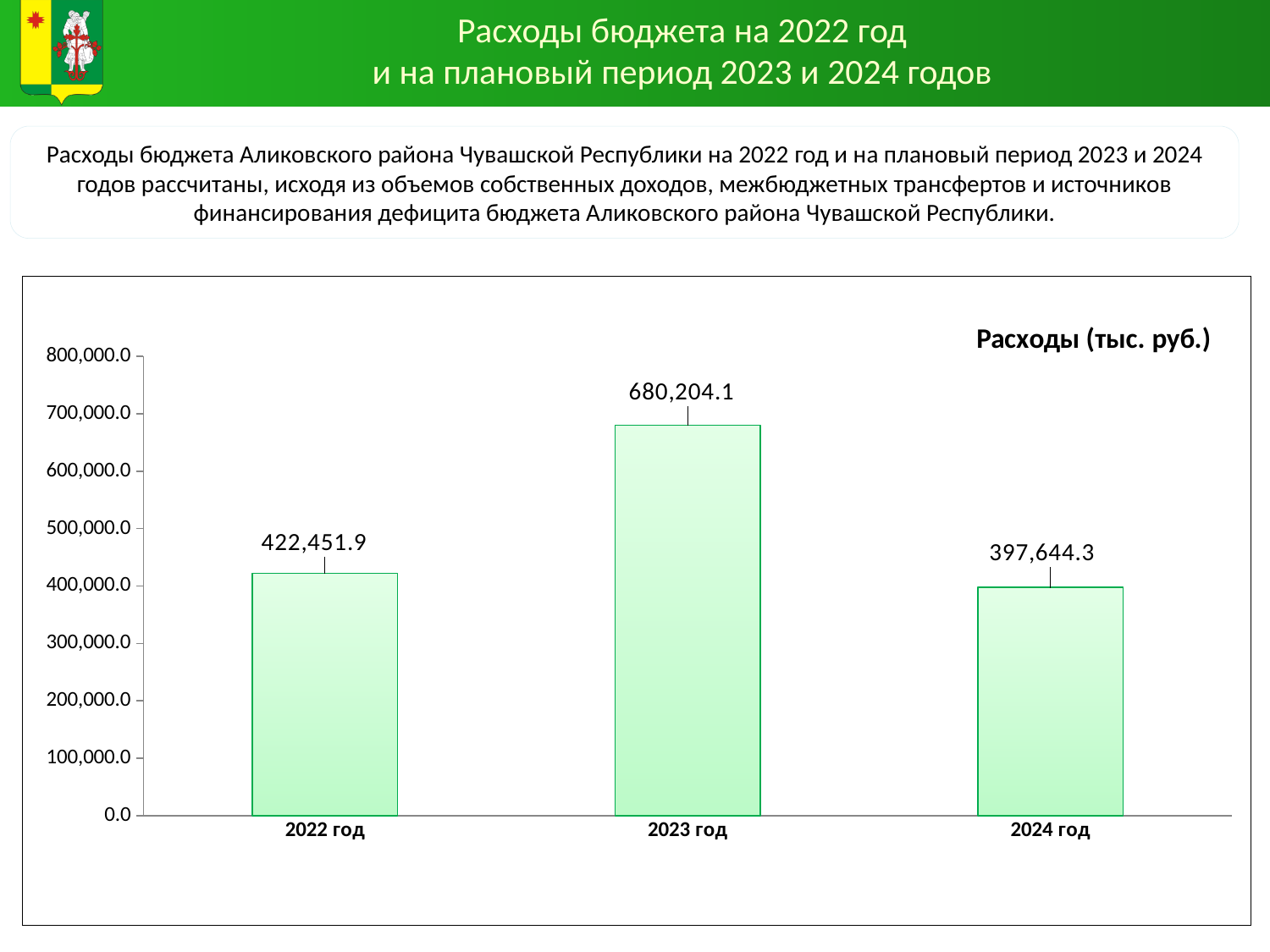
What is the difference between the values for 2022 год and 2024 год? 24,807.6 What is the value for 2024 год? 397,644.3 Which is larger, the value for 2022 год or the value for 2024 год? 2022 год Which year has the highest expenditure? 2023 год Is the value for 2023 год greater or less than 600,000.0? greater What is the title of the chart? Расходы (тыс. руб.) What is the value for 2023 год? 680,204.1 How many categories are shown on the x axis? 3 What kind of chart is shown on the slide? bar chart What is the difference between the values for 2023 год and 2022 год? 257,752.2 Which year has the lowest expenditure? 2024 год What is the value for 2022 год? 422,451.9